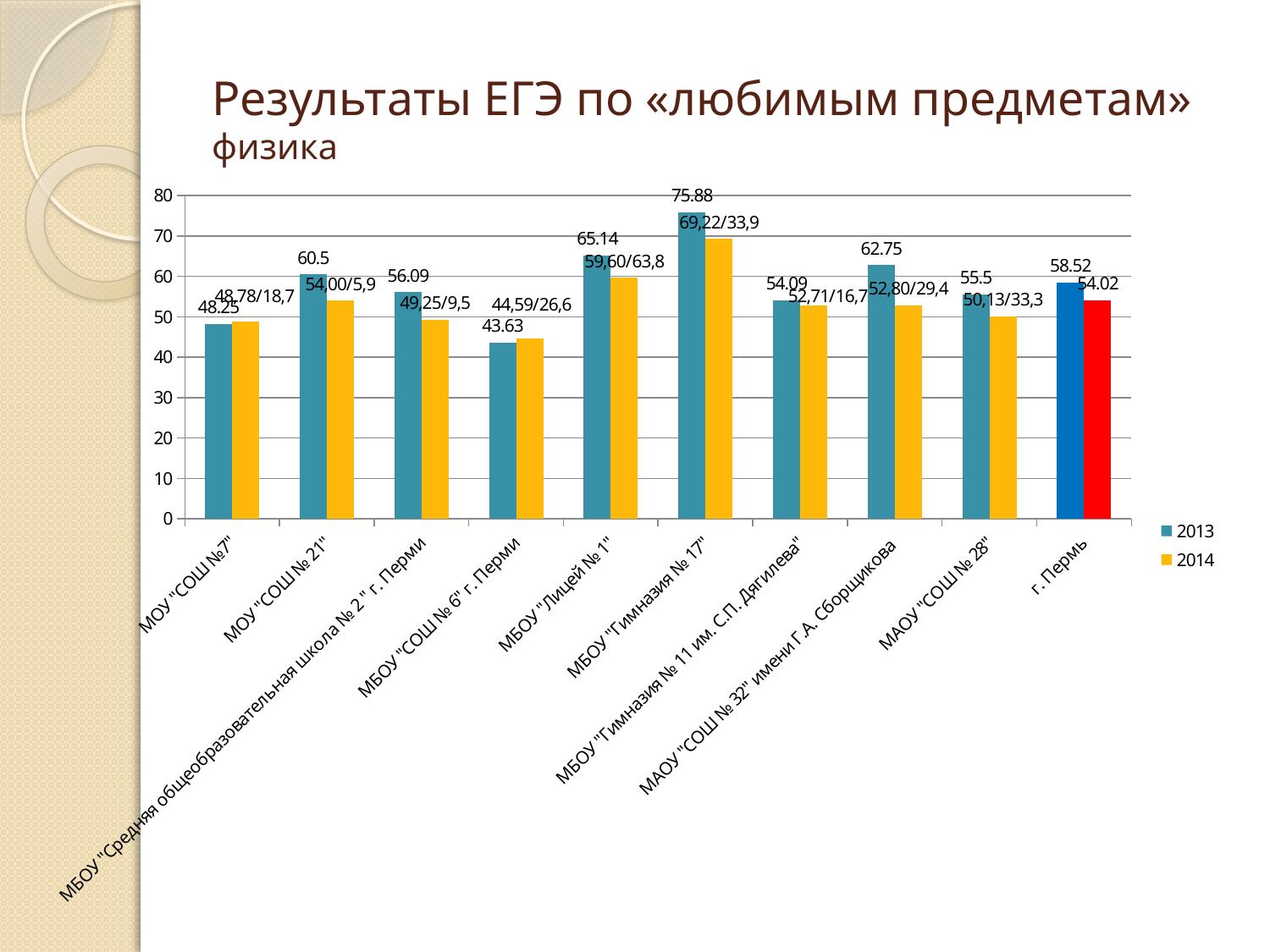
Is the 2014 value for МБОУ "Гимназия № 17" greater or less than 60? greater What is the 2013 value for МБОУ "СОШ № 6" г. Перми? 43.63 What is the 2013 value for МАОУ "СОШ № 32" имени Г.А. Сборщикова? 62.75 How many categories are shown on the x axis? 10 What is the 2013 value for МБОУ "Гимназия № 17"? 75.88 How many series does the legend list? 2 Which category has the highest 2013 value? МБОУ "Гимназия № 17" Which is larger, the 2013 value for МОУ "СОШ № 21" or the 2013 value for МАОУ "СОШ № 28"? МОУ "СОШ № 21" What type of chart is shown on the slide? bar chart What is the 2014 value for г. Пермь? 54.02 What is the difference between the 2013 values for МБОУ "Гимназия № 17" and МБОУ "Лицей № 1"? 10.74 Which category has the lowest 2013 value? МБОУ "СОШ № 6" г. Перми